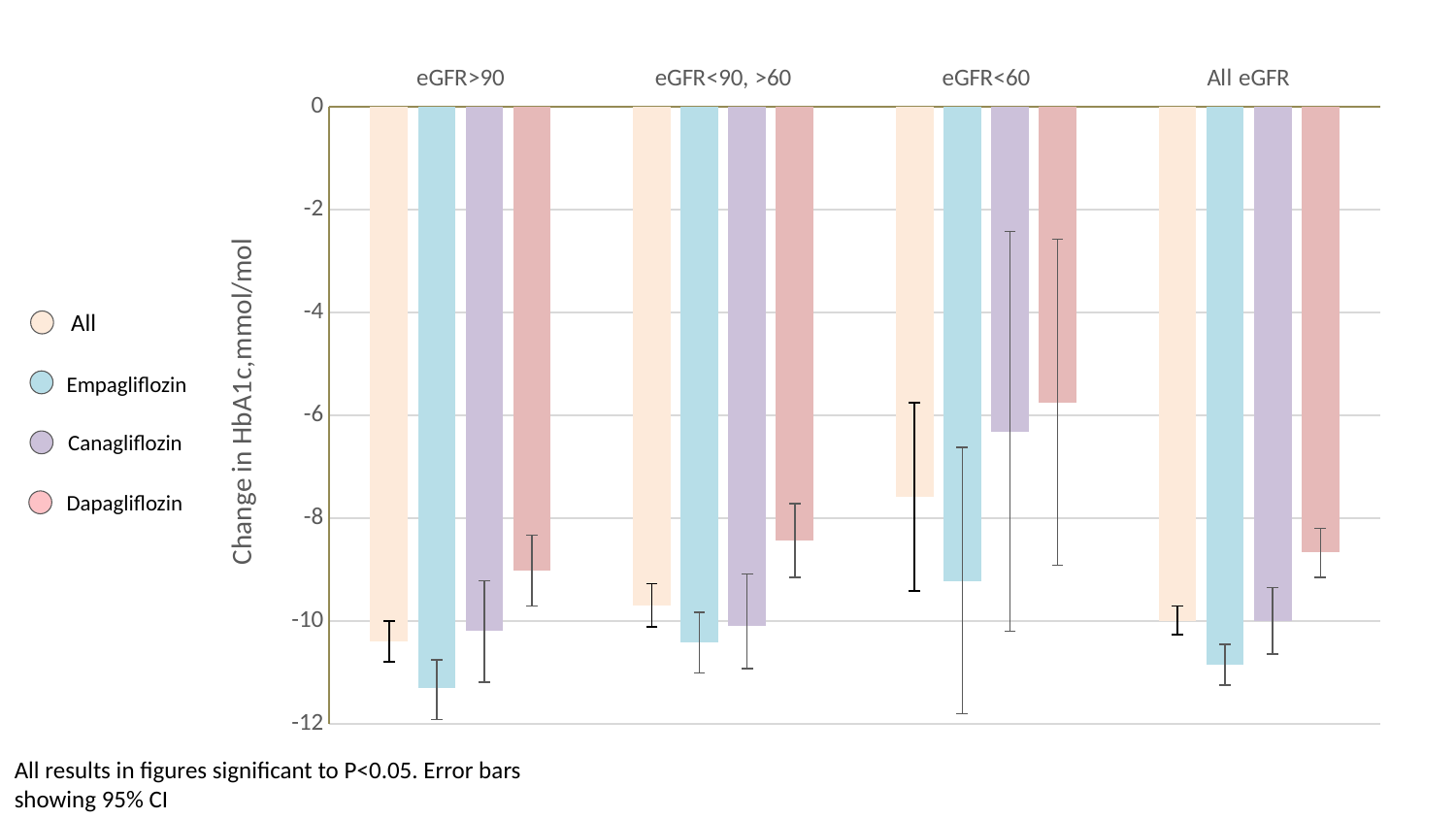
What kind of chart is shown on the slide? bar chart Is the value for Empagliflozin in the eGFR>90 group greater or less than -10? less Is the value for Dapagliflozin in the All eGFR group greater or less than -10? greater How many series does the legend list? 4 What is the label of the y axis? Change in HbA1c, mmol/mol Which series has the highest (closest to zero) value in the eGFR>90 group? Dapagliflozin How many eGFR groups are shown along the x axis? 4 Is the value for Dapagliflozin in the eGFR<60 group greater or less than -4? less Which is more negative: the Empagliflozin value in the eGFR<60 group or the Empagliflozin value in the All eGFR group? All eGFR Which series is shown in light blue in the legend? Empagliflozin Which series has the lowest (most negative) value in the eGFR>90 group? Empagliflozin Which series has the lowest (most negative) value in the eGFR<60 group? Empagliflozin